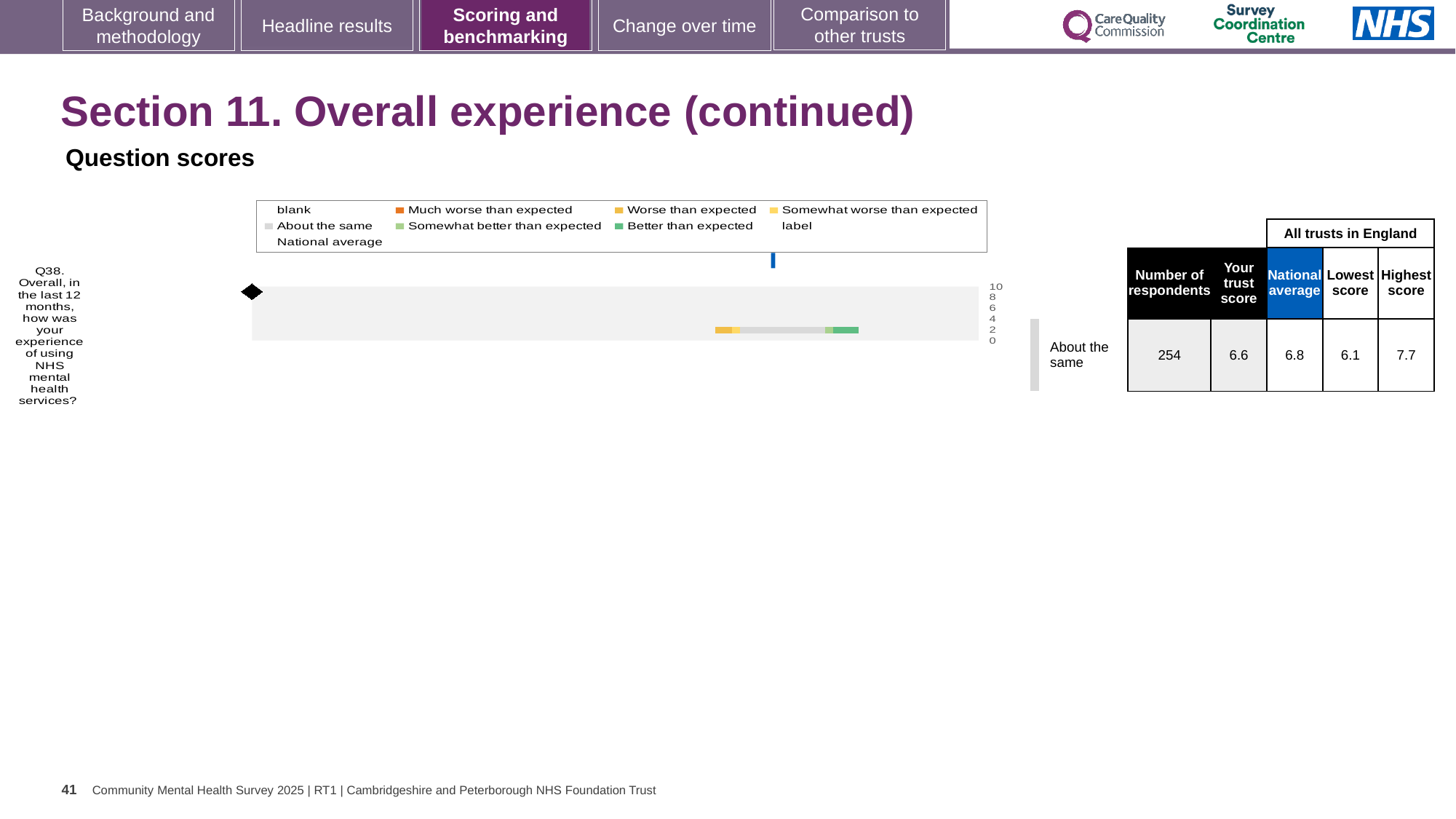
How many respondents answered Q38? 254 How many survey questions are plotted in the chart? 1 Which is larger for Q38, the trust's score or the national average? National average What is the highest score among all trusts in England for Q38? 7.7 What colour does the legend use for "Better than expected"? green What is the difference between the highest and lowest trust scores for Q38? 1.6 What kind of chart is used to show the Q38 question score? bar chart What is the trust's score for Q38 shown in the table beside the chart? 6.6 Which benchmarking category is the trust placed in for Q38? About the same What is the national average score for Q38 shown in the table beside the chart? 6.8 What is the lowest score among all trusts in England for Q38? 6.1 What does the blue vertical marker above the bar represent, according to the legend? National average